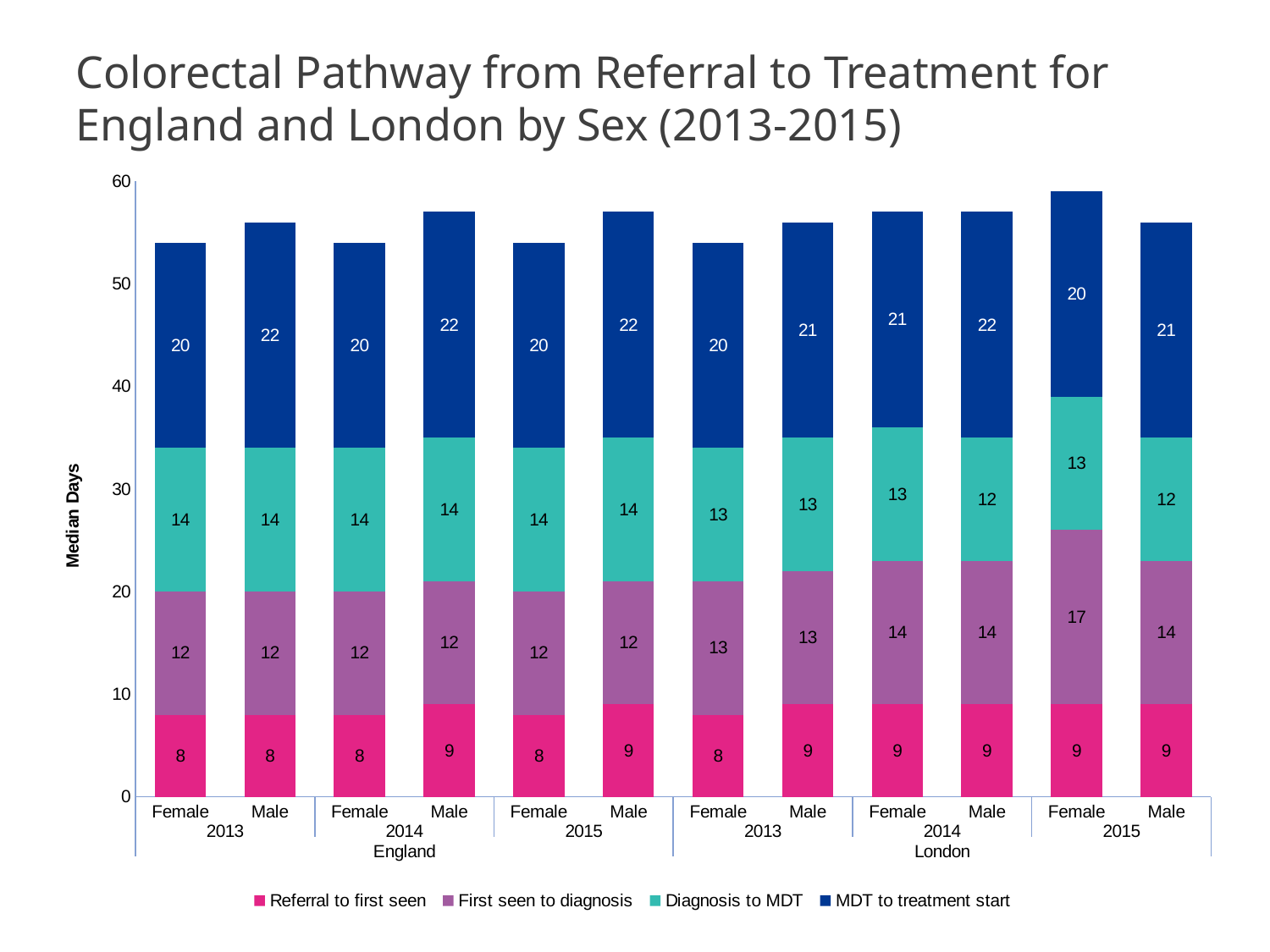
What is the value of 'MDT to treatment start' for England Male in 2014? 22 What is the value of 'Diagnosis to MDT' for London Male in 2014? 12 What is the value of 'First seen to diagnosis' for London Female in 2015? 17 How many series does the legend list? 4 Which is larger: 'MDT to treatment start' for England Male 2013 or England Female 2013? England Male 2013 What type of chart is shown on the slide? Stacked bar chart What is the total median days for the England Female 2013 bar? 54 Which bar has the highest total median days? London Female 2015 What is the total median days for the London Female 2015 bar? 59 What is the difference between 'First seen to diagnosis' for London Female 2015 and London Male 2015? 3 How many bars are plotted in the chart? 12 What is the value of 'Referral to first seen' for England Female in 2013? 8